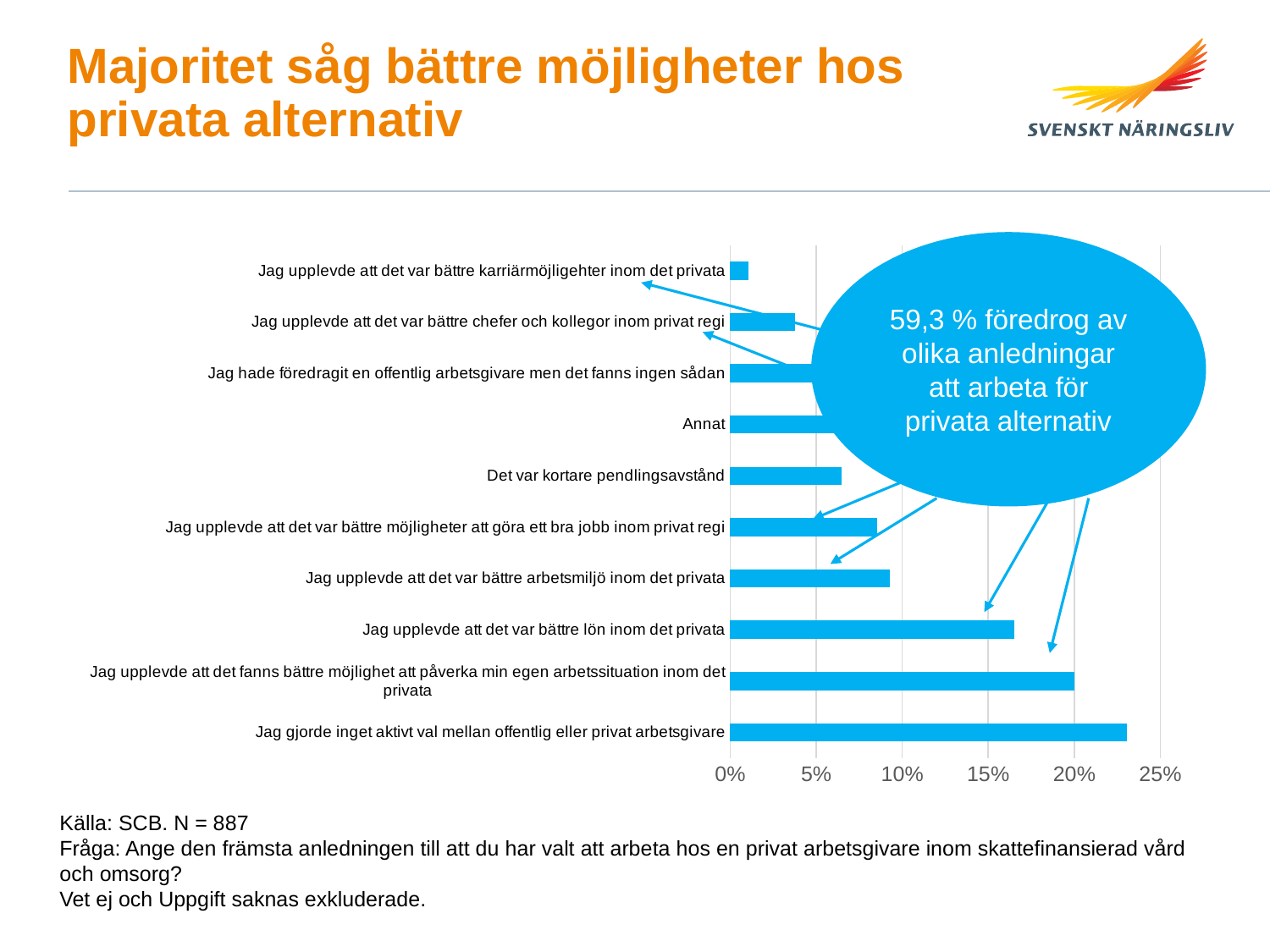
Do the bar values increase or decrease going from the top category to the bottom category? increase Is the value for "Jag upplevde att det var bättre arbetsmiljö inom det privata" greater or less than 10%? less What percentage does the callout bubble on the chart say preferred to work for private alternatives for various reasons? 59,3 % Is the value for "Jag upplevde att det var bättre lön inom det privata" greater or less than 15%? greater What kind of chart is shown on the slide? bar chart Which category has the highest value in the chart? Jag gjorde inget aktivt val mellan offentlig eller privat arbetsgivare Is the value for "Det var kortare pendlingsavstånd" greater or less than 5%? greater How many categories (reasons) are plotted in the chart? 10 Which is larger: the value for "Jag upplevde att det var bättre lön inom det privata" or for "Jag upplevde att det var bättre arbetsmiljö inom det privata"? Jag upplevde att det var bättre lön inom det privata Which category has the lowest value in the chart? Jag upplevde att det var bättre karriärmöjligehter inom det privata